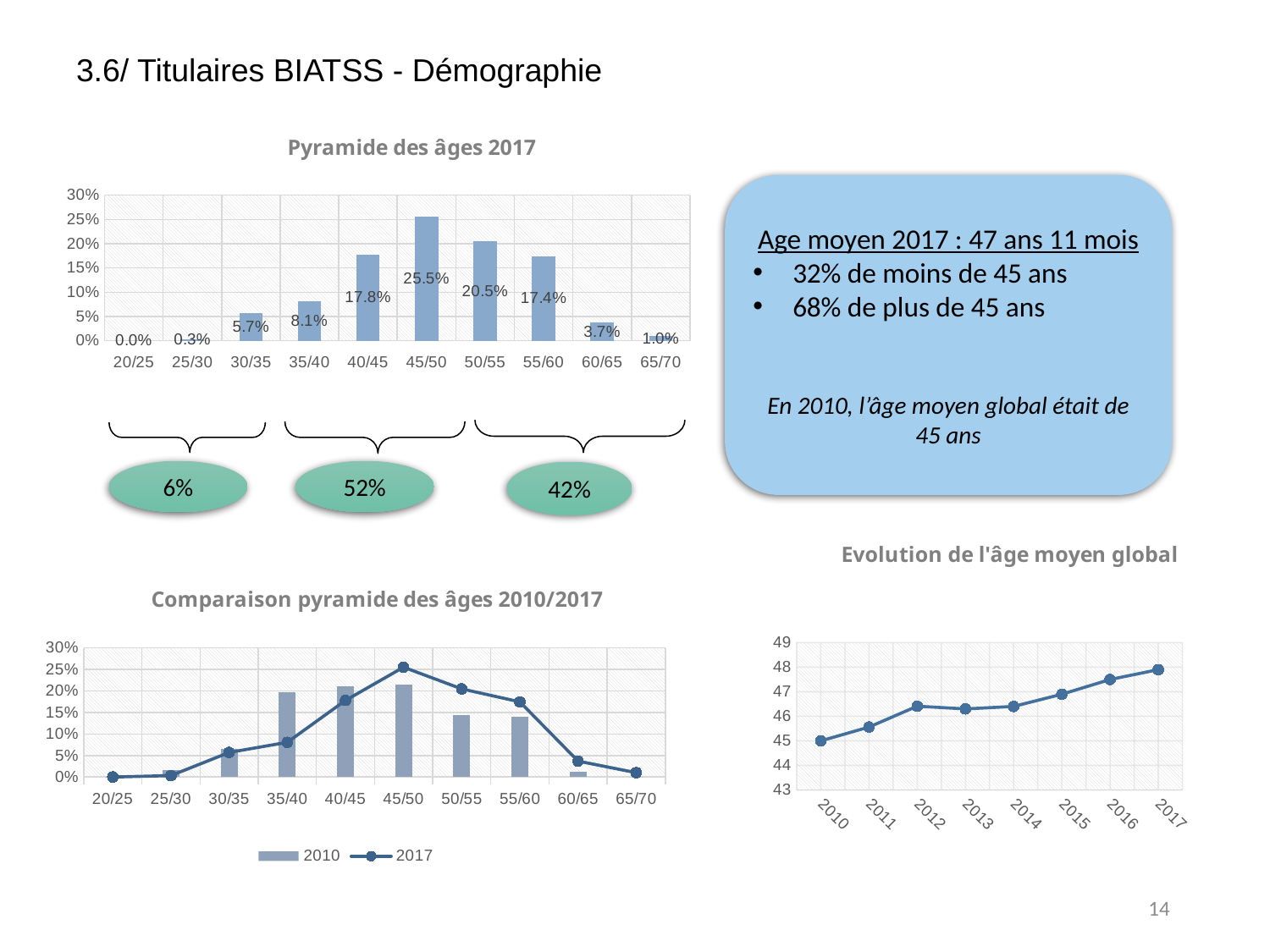
In the 'Comparaison pyramide des âges 2010/2017' chart, is the 2010 value for 35/40 greater or less than 15%? greater In the 'Pyramide des âges 2017' chart, which is larger, the value for 40/45 or the value for 55/60? 40/45 How many series does the legend of the 'Comparaison pyramide des âges 2010/2017' chart list? 2 In the 'Pyramide des âges 2017' chart, what is the difference between the values for 50/55 and 55/60? 3.1% In the 'Pyramide des âges 2017' chart, which age group has the highest value? 45/50 How many age groups are shown on the x axis of the 'Pyramide des âges 2017' chart? 10 In the 'Pyramide des âges 2017' chart, what is the value for the 45/50 age group? 25.5% In the 'Comparaison pyramide des âges 2010/2017' chart, which series has the higher value for 45/50, 2010 or 2017? 2017 In the 'Pyramide des âges 2017' chart, which age group has the lowest value? 20/25 In the 'Pyramide des âges 2017' chart, what is the value for the 35/40 age group? 8.1% In the 'Evolution de l'âge moyen global' chart, do the values generally rise or fall from 2010 to 2017? rise What kind of chart is 'Evolution de l'âge moyen global'? line chart